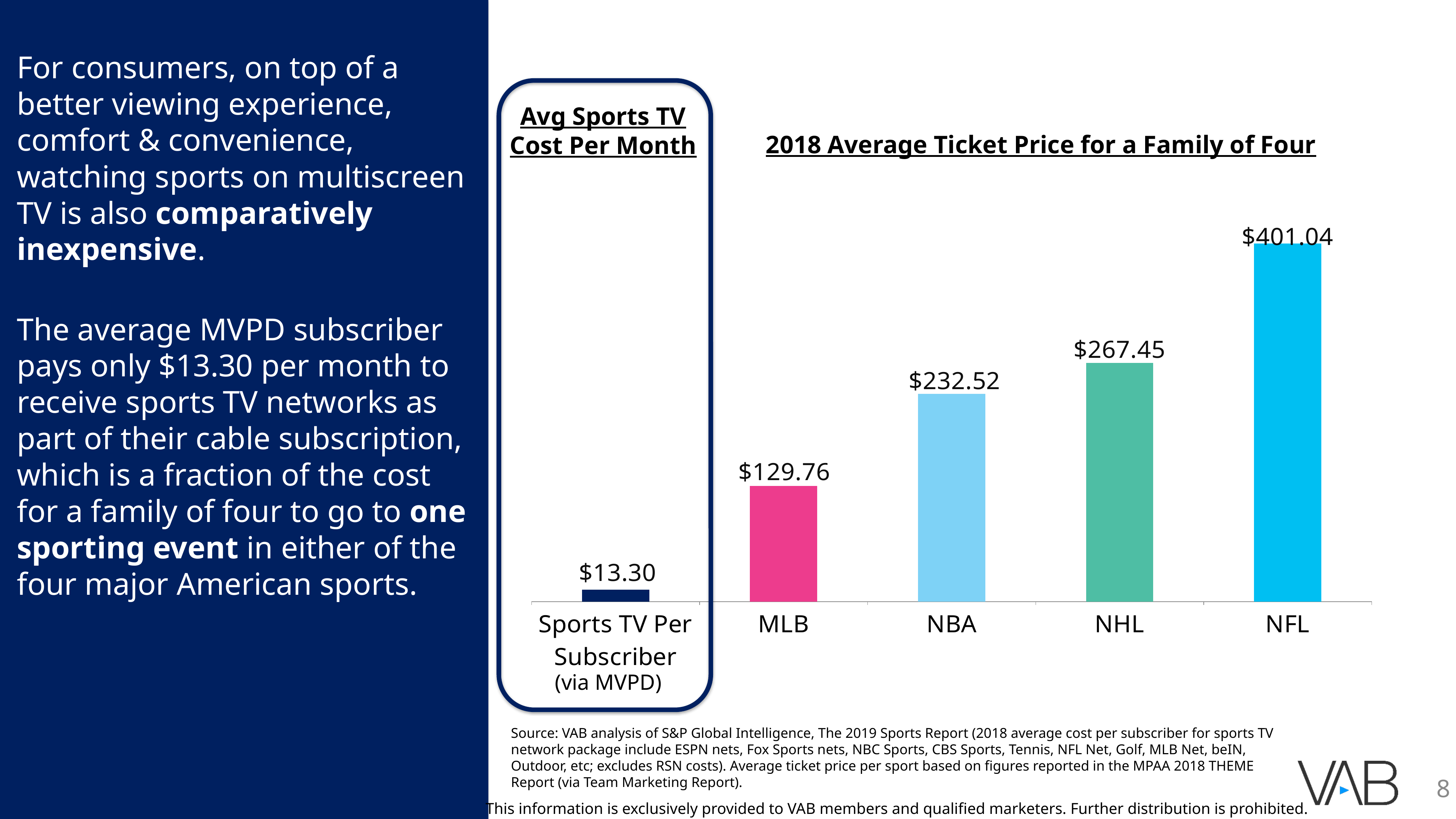
Which category has the lowest value in the chart? Sports TV Per Subscriber (via MVPD) What type of chart is shown on the slide? Bar chart What is the 2018 average ticket price for a family of four for the NHL? $267.45 What is the 2018 average ticket price for a family of four for the NFL? $401.04 What is the difference between the NFL and NHL average ticket prices? $133.59 Which category has the highest value in the chart? NFL What is the title of the chart section covering the four sports leagues? 2018 Average Ticket Price for a Family of Four What is the difference between the NBA and MLB average ticket prices? $102.76 What is the average sports TV cost per month per subscriber (via MVPD)? $13.30 Which is larger, the NBA ticket price or the NHL ticket price? NHL How many bars are shown in the chart? 5 What is the 2018 average ticket price for a family of four for the MLB? $129.76